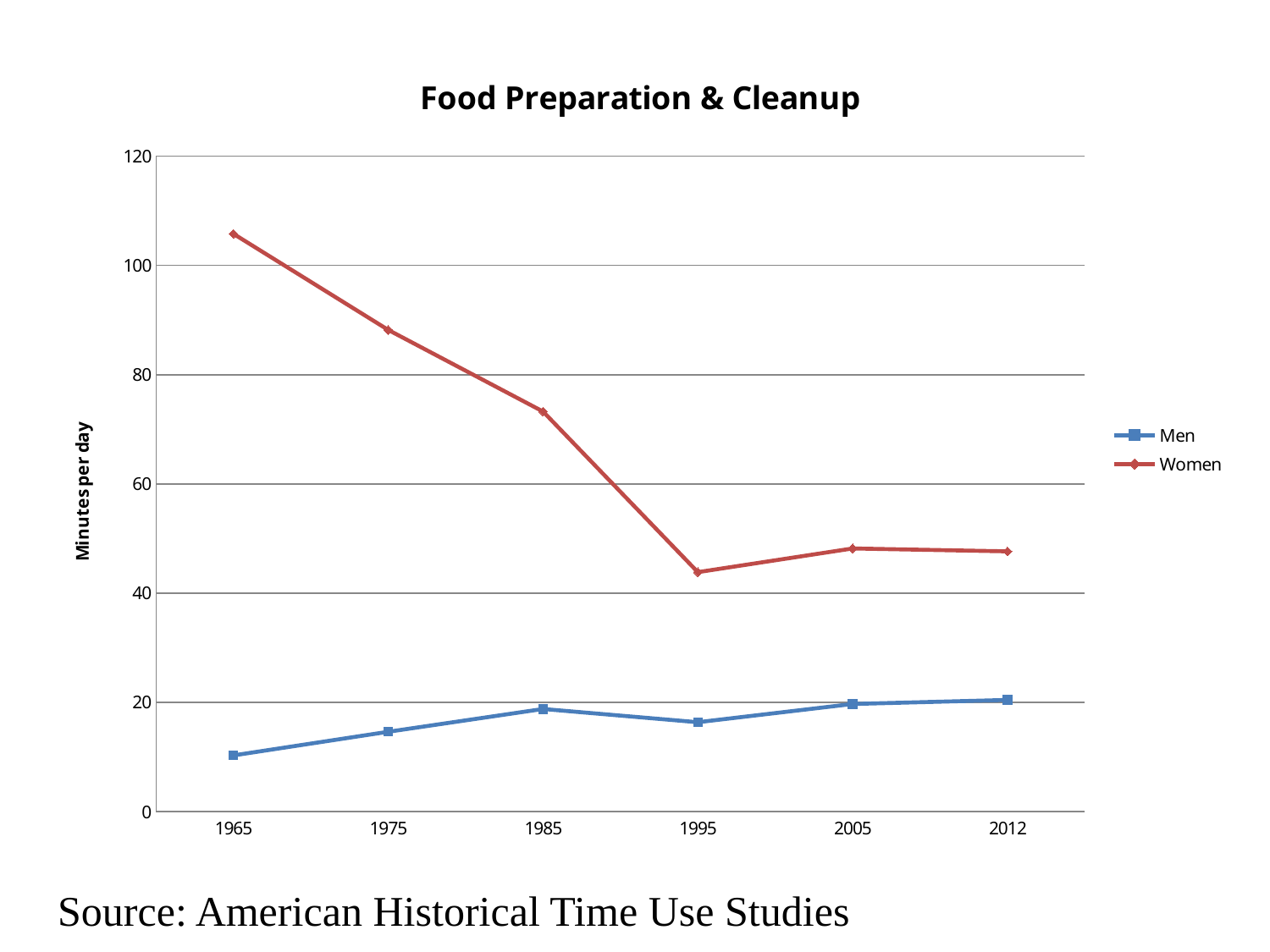
In which year is the value for Women highest? 1965 Does the value for Women rise or fall from 1965 to 1995? fall How many years are plotted along the x axis? 6 How many series does the legend list? 2 What is the label on the vertical axis? Minutes per day In which year is the value for Men lowest? 1965 Is the value for Men in 1965 greater or less than 20? less What kind of chart is shown on the slide? line chart Is the value for Women in 1985 greater or less than 80? less In which year is the value for Women lowest? 1995 Is the value for Women in 1965 greater or less than 100? greater Which series has the larger value in 1985, Men or Women? Women